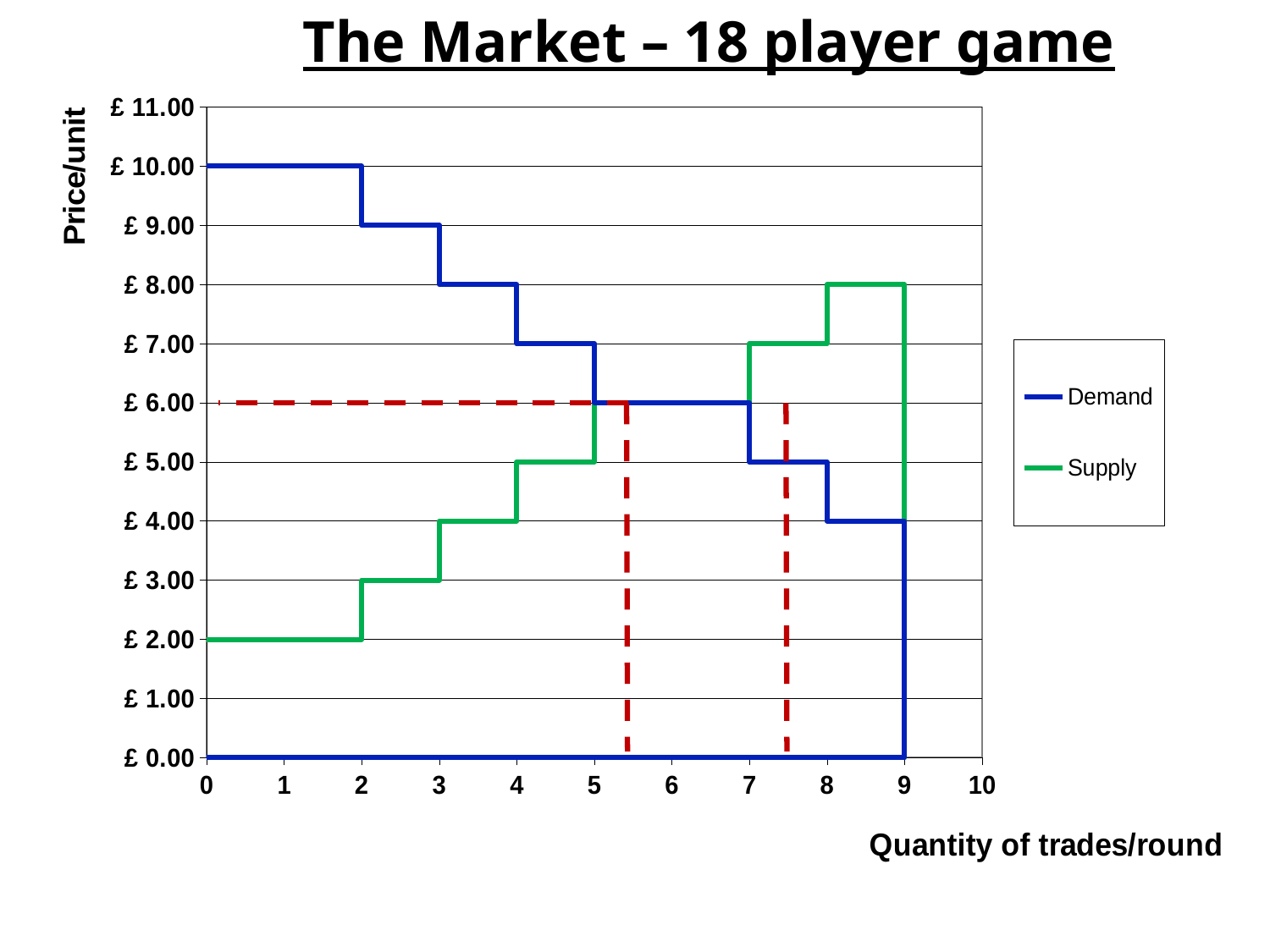
What is the Demand price for quantities between 0 and 2 trades per round? £ 10.00 What is the lowest price on the Supply line? £ 2.00 What is the Supply price for quantities between 0 and 2 trades per round? £ 2.00 What is the highest price on the Demand line? £ 10.00 What is the Demand price for quantities between 8 and 9 trades per round? £ 4.00 What is the difference between the Demand price and the Supply price at a quantity of 1 trade per round? £ 8.00 What is the label of the horizontal axis? Quantity of trades/round How many series does the legend list? 2 What is the Supply price for quantities between 8 and 9 trades per round? £ 8.00 What kind of chart is shown on the slide? Line chart What is the title of the chart? The Market – 18 player game Does the Demand price rise or fall as the quantity of trades increases? Fall